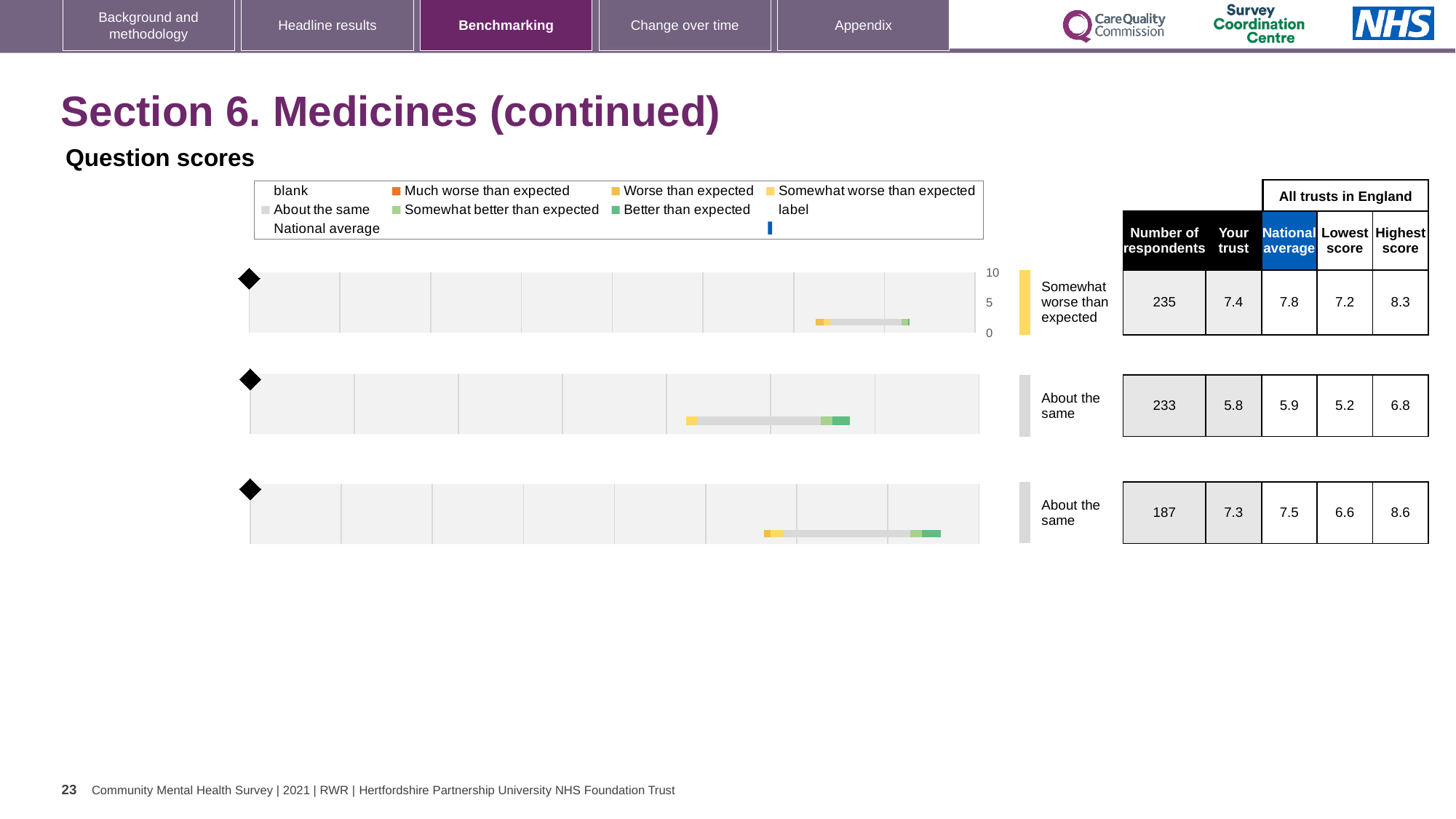
For the top chart, what is the 'Your trust' score? 7.4 For the middle chart, which is larger: the 'Your trust' score or the national average? National average In the top chart, is the 'Your trust' score greater or less than 5? greater Which of the three charts has the lowest 'Your trust' score? the middle chart For the bottom chart, what is the difference between the highest score and the lowest score? 2.0 For the middle chart, what is the number of respondents? 233 For the top chart, what is the national average score? 7.8 How many question-score charts are shown on the slide? 3 What kind of chart is used for the question scores on this slide? bar chart What benchmark rating label is shown next to the top chart? Somewhat worse than expected For the bottom chart, what is the highest score among all trusts in England? 8.6 For the top chart, what is the difference between the national average and the 'Your trust' score? 0.4